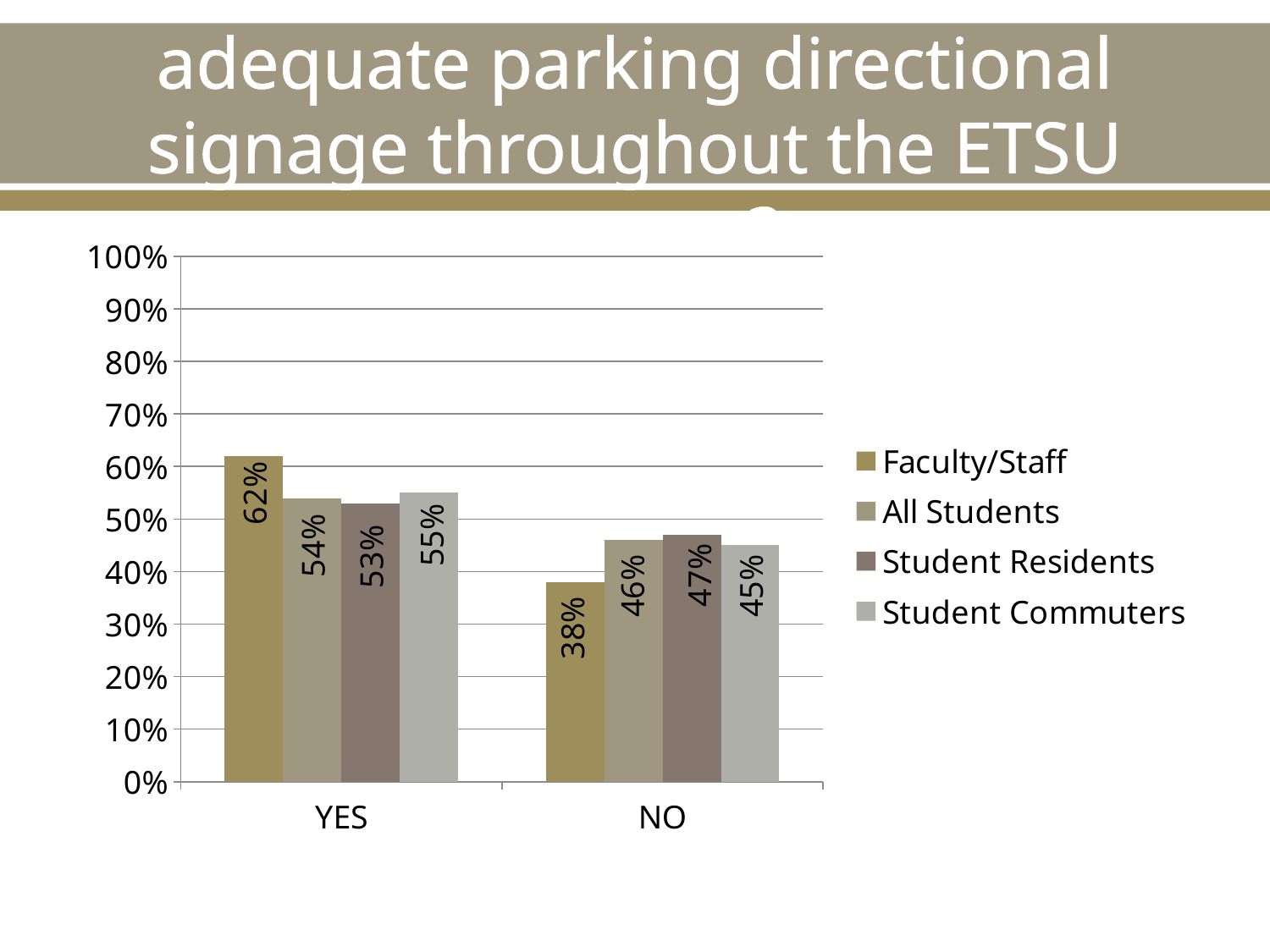
What is the value for All Students in the NO category? 46% Which series has the lowest value in the NO category? Faculty/Staff What kind of chart is shown on the slide? bar chart How many series does the legend list? 4 Which is larger: the Student Commuters YES value or the All Students YES value? Student Commuters YES value What percentage of Faculty/Staff answered YES? 62% What is the difference between the Faculty/Staff YES value and the Faculty/Staff NO value? 24% What is the value for Student Residents in the NO category? 47% What is the value for Student Commuters in the YES category? 55% Is the value for Faculty/Staff in the NO category greater or less than 40%? less How many categories are shown on the x axis? 2 Which series has the highest value in the YES category? Faculty/Staff